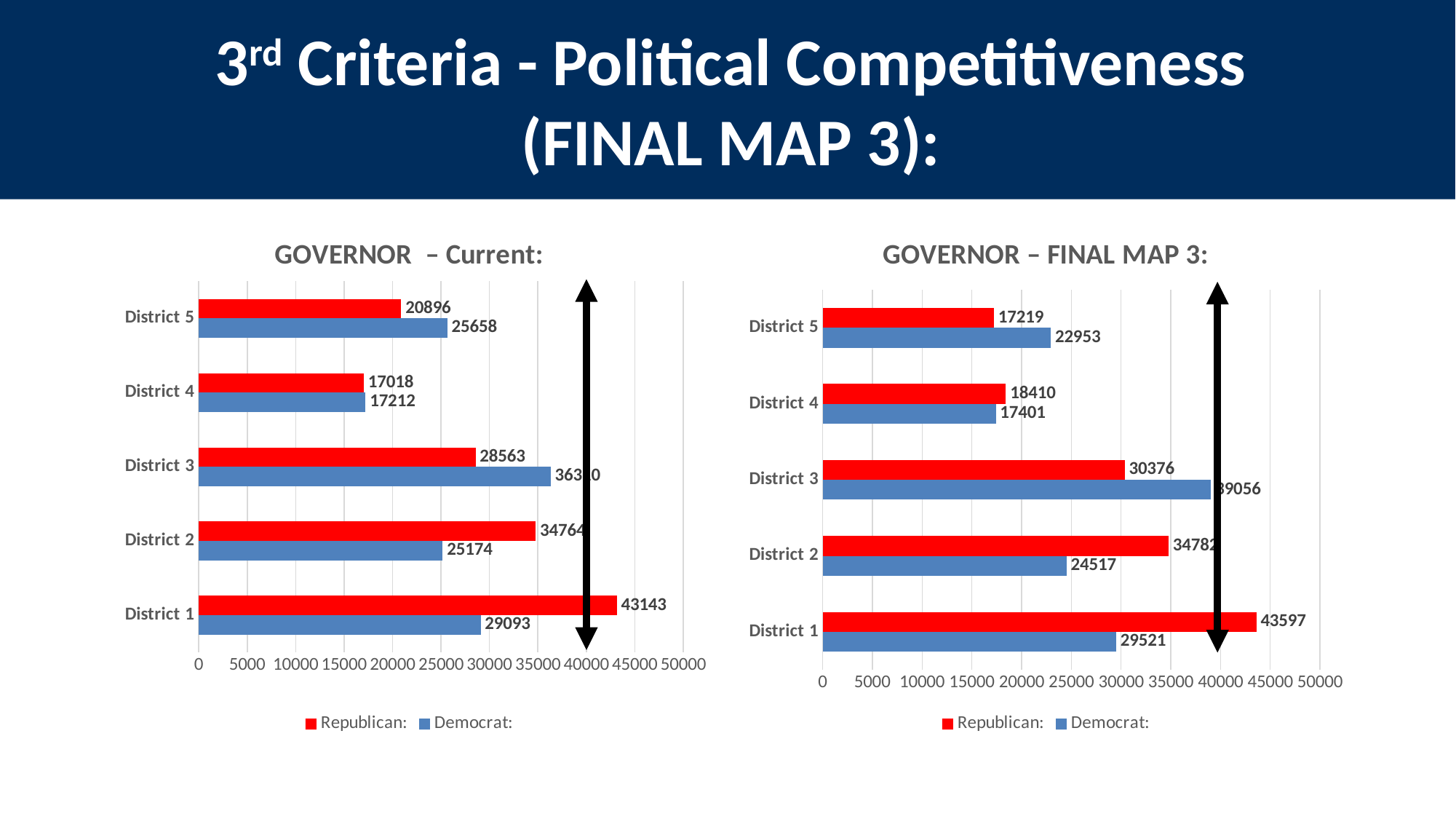
How many districts are shown in the GOVERNOR – Current chart? 5 In the GOVERNOR – FINAL MAP 3 chart, what is the Democrat value for District 2? 24517 In the GOVERNOR – FINAL MAP 3 chart, which district has the highest Republican value? District 1 In the GOVERNOR – Current chart, what is the Democrat value for District 5? 25658 How many series does the legend of the GOVERNOR – FINAL MAP 3 chart list? 2 In the GOVERNOR – Current chart, what is the Republican value for District 1? 43143 In the GOVERNOR – FINAL MAP 3 chart, what is the difference between the Republican and Democrat values for District 5? 5734 What type of chart is the GOVERNOR – Current chart? Bar chart In the GOVERNOR – FINAL MAP 3 chart, what is the Republican value for District 4? 18410 In the GOVERNOR – FINAL MAP 3 chart, which is larger for District 4, the Republican value or the Democrat value? Republican In the GOVERNOR – Current chart, what is the difference between the Republican and Democrat values for District 2? 9590 In the GOVERNOR – Current chart, which district has the lowest Republican value? District 4